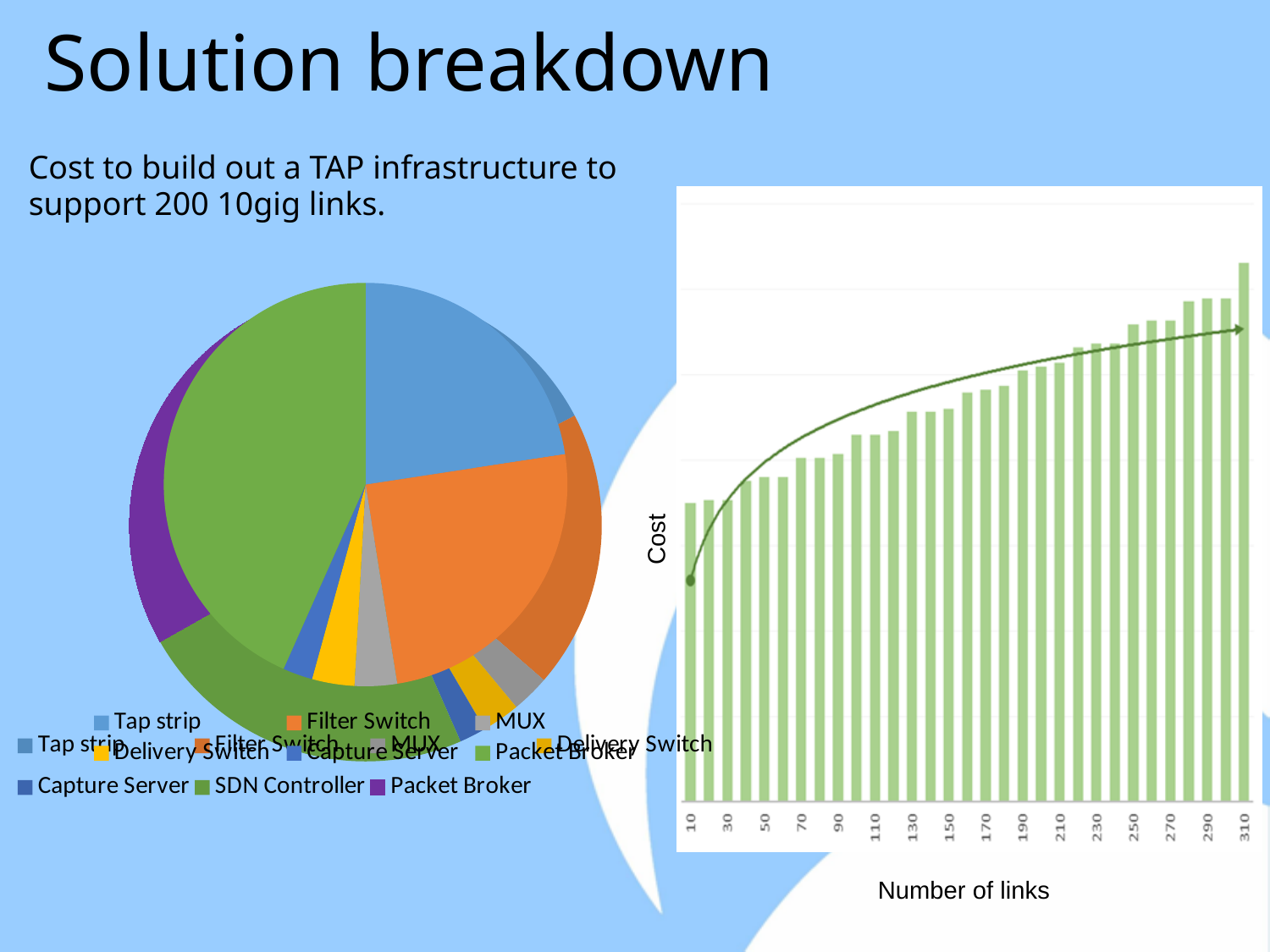
What is the x-axis label of the bar chart on the right? Number of links What kind of chart is shown on the left side of the slide? pie chart In the bar chart on the right, which number of links has the tallest bar? 310 In the front pie chart on the left, which category has the largest slice? Packet Broker In the bar chart on the right, is the bar for 250 links taller or shorter than the bar for 110 links? taller What kind of chart is the chart on the right side of the slide? bar chart How many entries does the legend of the front pie chart on the left list? 6 What is the y-axis label of the bar chart on the right? Cost How many tick labels are printed along the x axis of the bar chart on the right? 16 In the bar chart on the right, is the bar for 10 links taller or shorter than the bar for 310 links? shorter In the bar chart on the right, do the bars rise or fall as the number of links increases along the x axis? rise